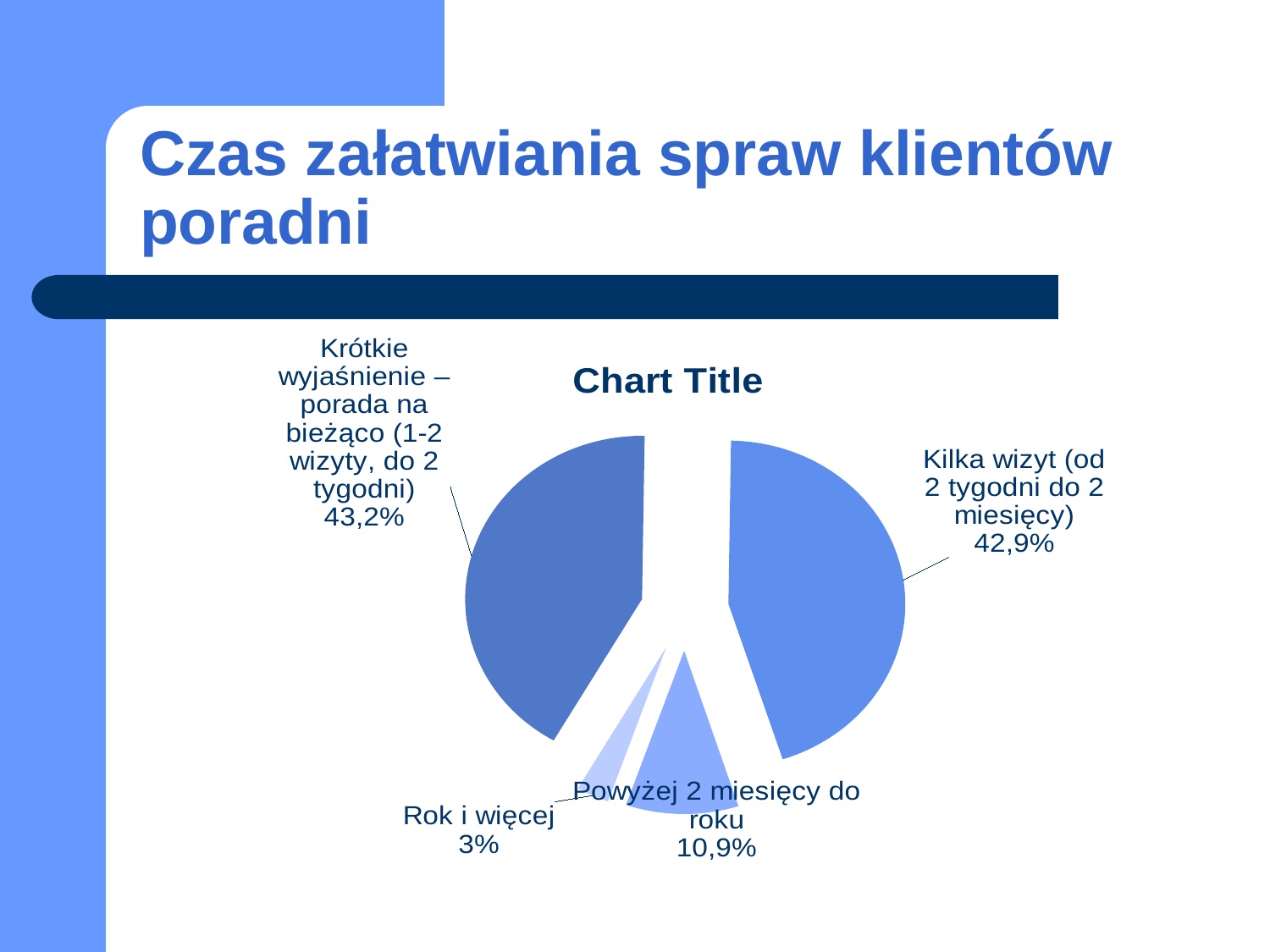
What share of the pie does "Rok i więcej" represent? 3% What is the difference in percentage points between "Powyżej 2 miesięcy do roku" and "Rok i więcej"? 7,9 What value is labelled for "Kilka wizyt (od 2 tygodni do 2 miesięcy)"? 42,9% How many slices does the pie chart have? 4 What percentage is shown for "Krótkie wyjaśnienie – porada na bieżąco (1-2 wizyty, do 2 tygodni)"? 43,2% What type of chart is shown on the slide? Pie chart What title is printed above the chart? Chart Title Which category has the smallest slice of the pie? Rok i więcej What percentage is shown for "Powyżej 2 miesięcy do roku"? 10,9% Which is larger: the slice for "Powyżej 2 miesięcy do roku" or the slice for "Rok i więcej"? Powyżej 2 miesięcy do roku Which category has the largest slice of the pie according to the printed labels? Krótkie wyjaśnienie – porada na bieżąco (1-2 wizyty, do 2 tygodni) What is the difference in percentage points between "Krótkie wyjaśnienie – porada na bieżąco (1-2 wizyty, do 2 tygodni)" and "Kilka wizyt (od 2 tygodni do 2 miesięcy)"? 0,3